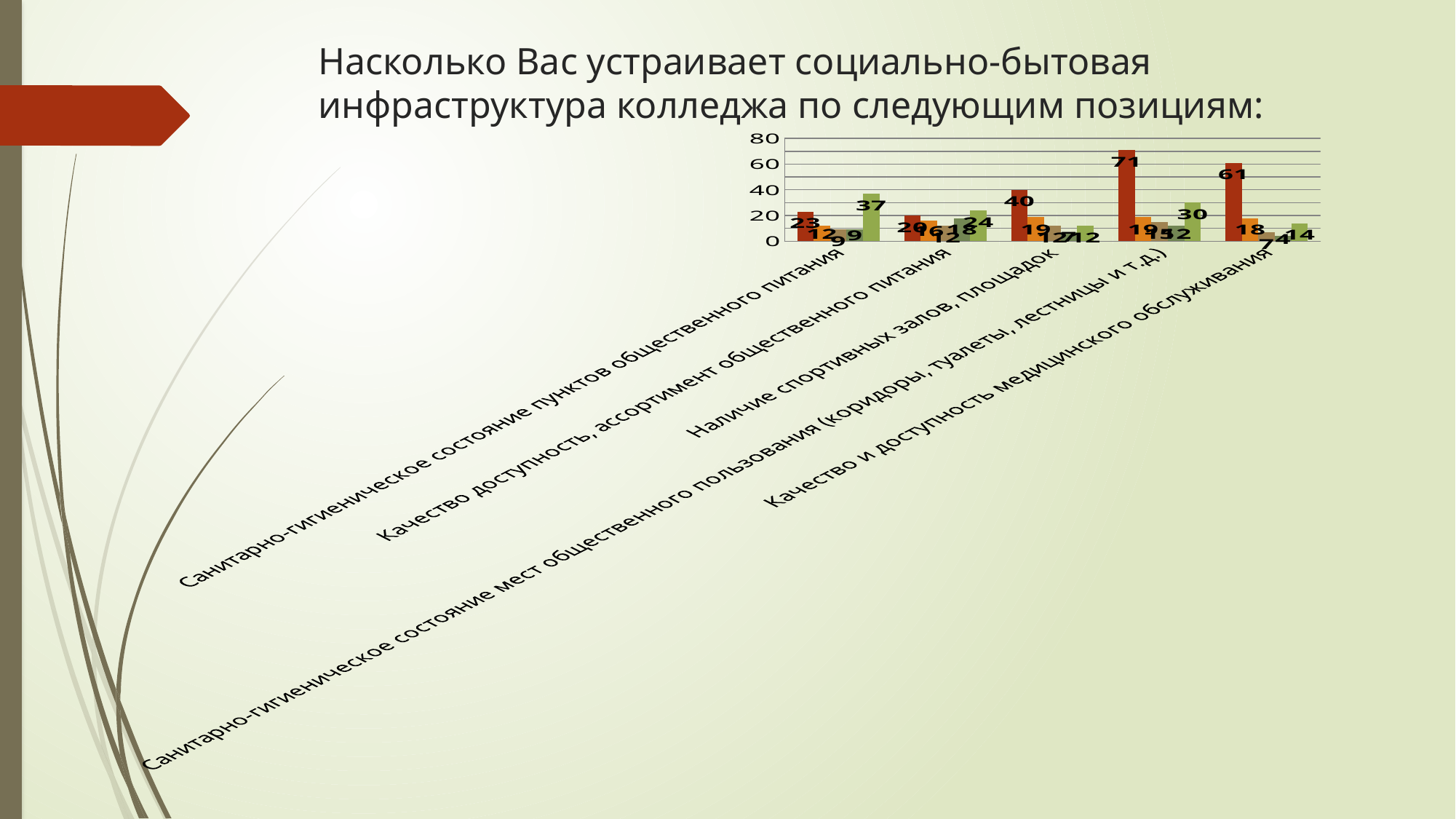
What is the value of the red bar for 'Качество и доступность медицинского обслуживания'? 61 What type of chart is shown on the slide? bar chart Is the value of the red bar for 'Санитарно-гигиеническое состояние пунктов общественного питания' greater or less than 40? less What is the value of the green (last) bar for 'Санитарно-гигиеническое состояние мест общественного пользования (коридоры, туалеты, лестницы и т.д.)'? 30 What is the value of the green (last) bar for 'Санитарно-гигиеническое состояние пунктов общественного питания'? 37 What is the value of the tallest (red) bar for 'Санитарно-гигиеническое состояние мест общественного пользования (коридоры, туалеты, лестницы и т.д.)'? 71 What is the value of the red bar for 'Наличие спортивных залов, площадок'? 40 Which category has the highest bar in the chart? Санитарно-гигиеническое состояние мест общественного пользования (коридоры, туалеты, лестницы и т.д.) What is the difference between the red bar for 'Санитарно-гигиеническое состояние мест общественного пользования' (71) and the red bar for 'Качество и доступность медицинского обслуживания' (61)? 10 How many categories are shown along the x axis of the chart? 5 Which is larger: the red bar for 'Санитарно-гигиеническое состояние мест общественного пользования' or the red bar for 'Качество и доступность медицинского обслуживания'? Санитарно-гигиеническое состояние мест общественного пользования How many bars are plotted for each category in the chart? 5